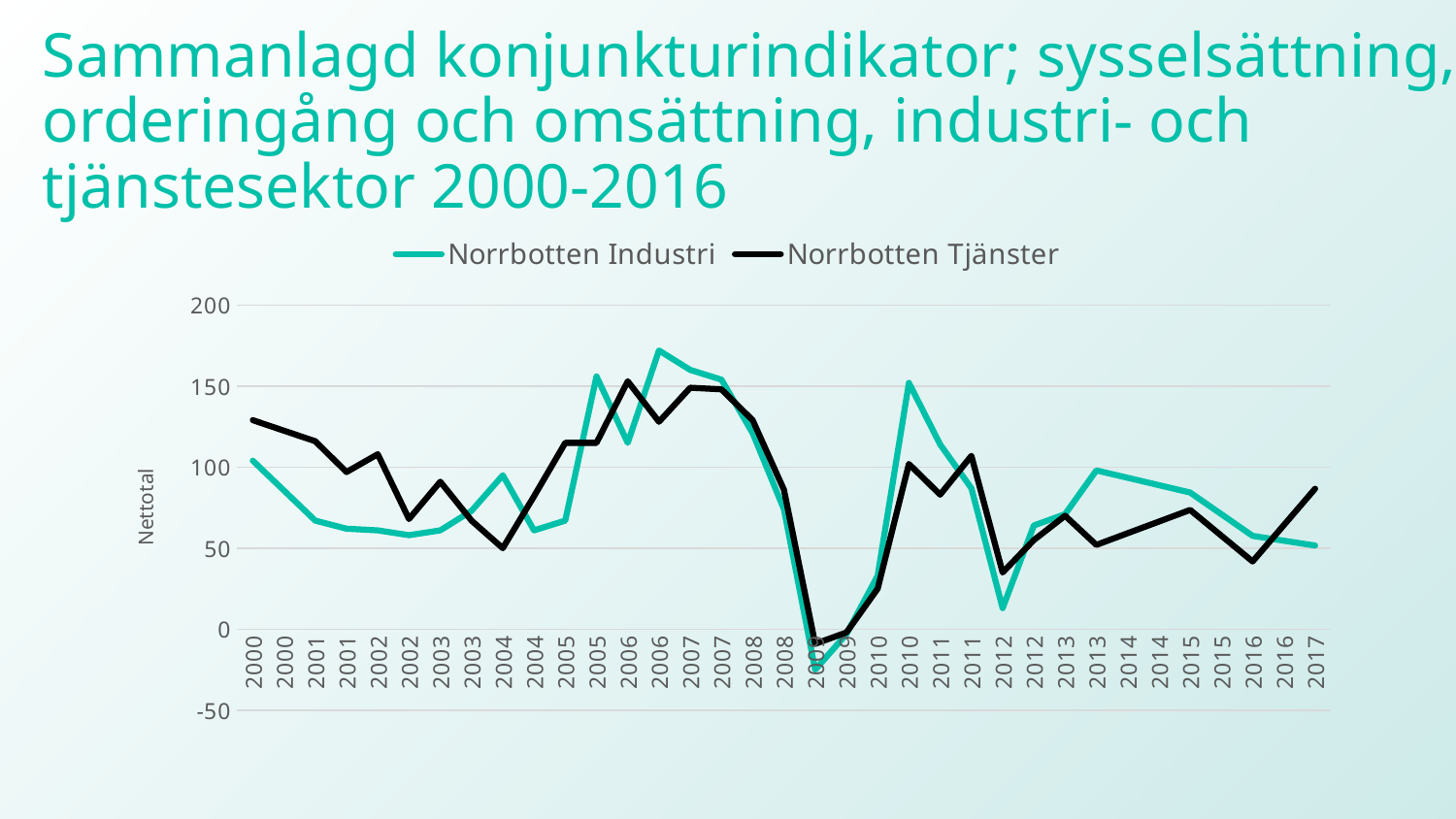
Is the value for Norrbotten Tjänster at the first 2000 point greater or less than 100? greater At the second 2010 point, which series has the larger value, Norrbotten Industri or Norrbotten Tjänster? Norrbotten Industri Is the peak value of Norrbotten Industri around 2006 greater or less than 150? greater Which series reaches the highest value anywhere on the chart? Norrbotten Industri At the first 2000 point, which series has the larger value, Norrbotten Industri or Norrbotten Tjänster? Norrbotten Tjänster What are the two series named in the legend? Norrbotten Industri and Norrbotten Tjänster How many series does the legend list? 2 Do both series rise or fall between 2007 and 2009? fall Is the value for Norrbotten Industri at the first 2012 point greater or less than 50? less What is the label on the vertical axis? Nettotal What kind of chart is shown on the slide? line chart